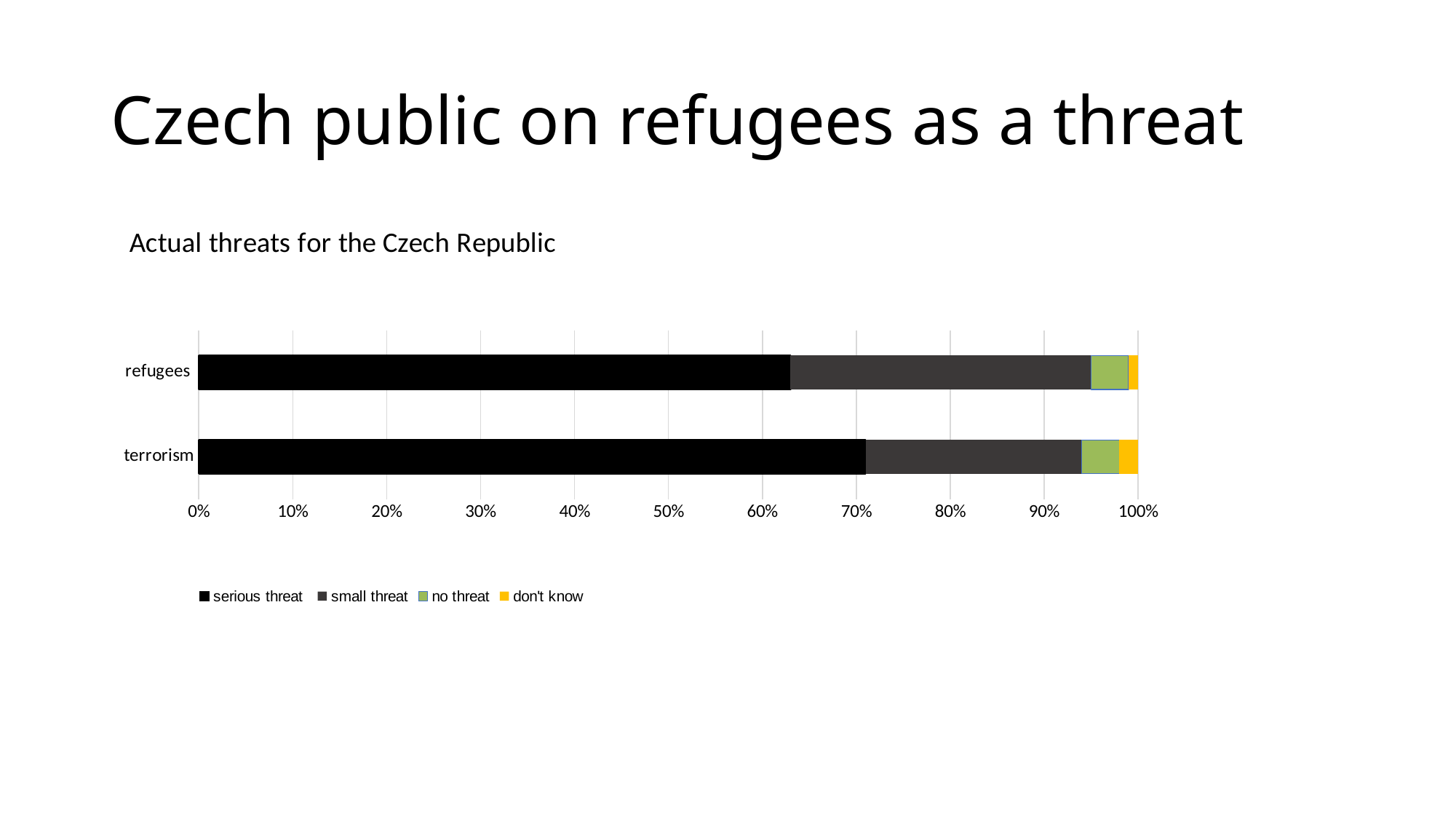
Is the 'serious threat' value for refugees greater or less than 60%? greater How many categories are plotted on the chart? 2 What is the title of the chart? Actual threats for the Czech Republic How many series does the legend list? 4 Is the 'serious threat' value for terrorism greater or less than 80%? less Which category has the smallest 'serious threat' share? refugees Which category has the largest 'serious threat' share? terrorism Is the 'serious threat' value for terrorism greater or less than 60%? greater Which category has the larger 'serious threat' segment, refugees or terrorism? terrorism Which series is shown in yellow in the legend? don't know What kind of chart is shown on the slide? stacked bar chart